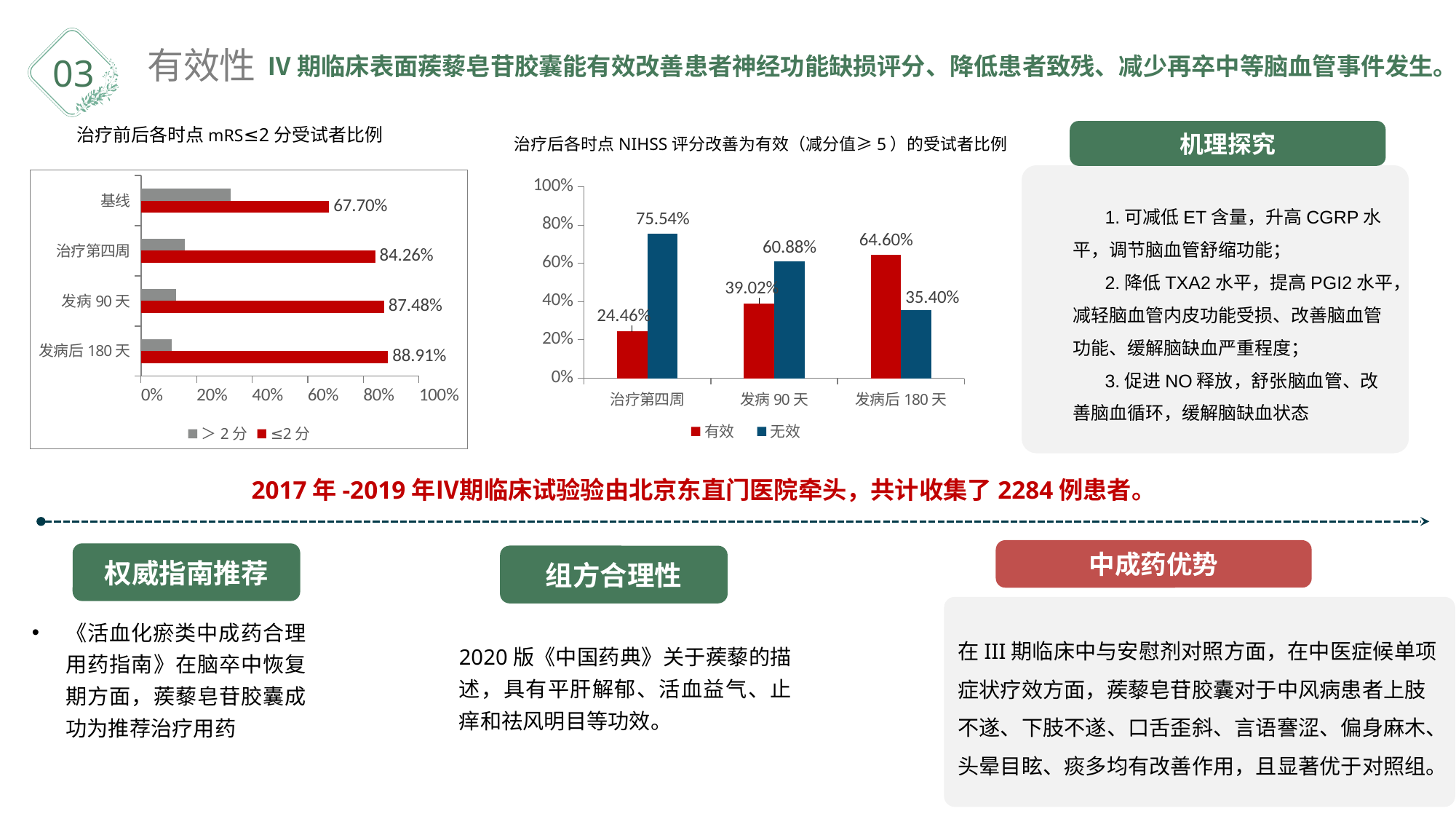
In the chart titled 治疗前后各时点 mRS≤2 分受试者比例, what is the value of the ≤2 分 series for 发病后 180 天? 88.91% In the chart titled 治疗后各时点 NIHSS 评分改善为有效（减分值≥5）的受试者比例, what is the 有效 value for 发病 90 天? 39.02% In the chart titled 治疗前后各时点 mRS≤2 分受试者比例, does the ≤2 分 value rise or fall from 基线 to 发病后 180 天? rise In the chart titled 治疗前后各时点 mRS≤2 分受试者比例, how many categories are shown? 4 In the chart titled 治疗前后各时点 mRS≤2 分受试者比例, what is the value of the ≤2 分 series at 基线? 67.70% In the chart titled 治疗后各时点 NIHSS 评分改善为有效（减分值≥5）的受试者比例, what is the 无效 value for 治疗第四周? 75.54% In the chart titled 治疗后各时点 NIHSS 评分改善为有效（减分值≥5）的受试者比例, which is larger at 发病后 180 天, 有效 or 无效? 有效 In the chart titled 治疗前后各时点 mRS≤2 分受试者比例, which category has the highest ≤2 分 value? 发病后 180 天 In the chart titled 治疗前后各时点 mRS≤2 分受试者比例, what is the difference between the ≤2 分 values for 治疗第四周 and 基线? 16.56% In the chart titled 治疗前后各时点 mRS≤2 分受试者比例, is the ＞2 分 value at 基线 greater or less than 40%? less In the chart titled 治疗后各时点 NIHSS 评分改善为有效（减分值≥5）的受试者比例, what is the difference between the 有效 values for 发病后 180 天 and 治疗第四周? 40.14% In the chart titled 治疗后各时点 NIHSS 评分改善为有效（减分值≥5）的受试者比例, how many series does the legend list? 2